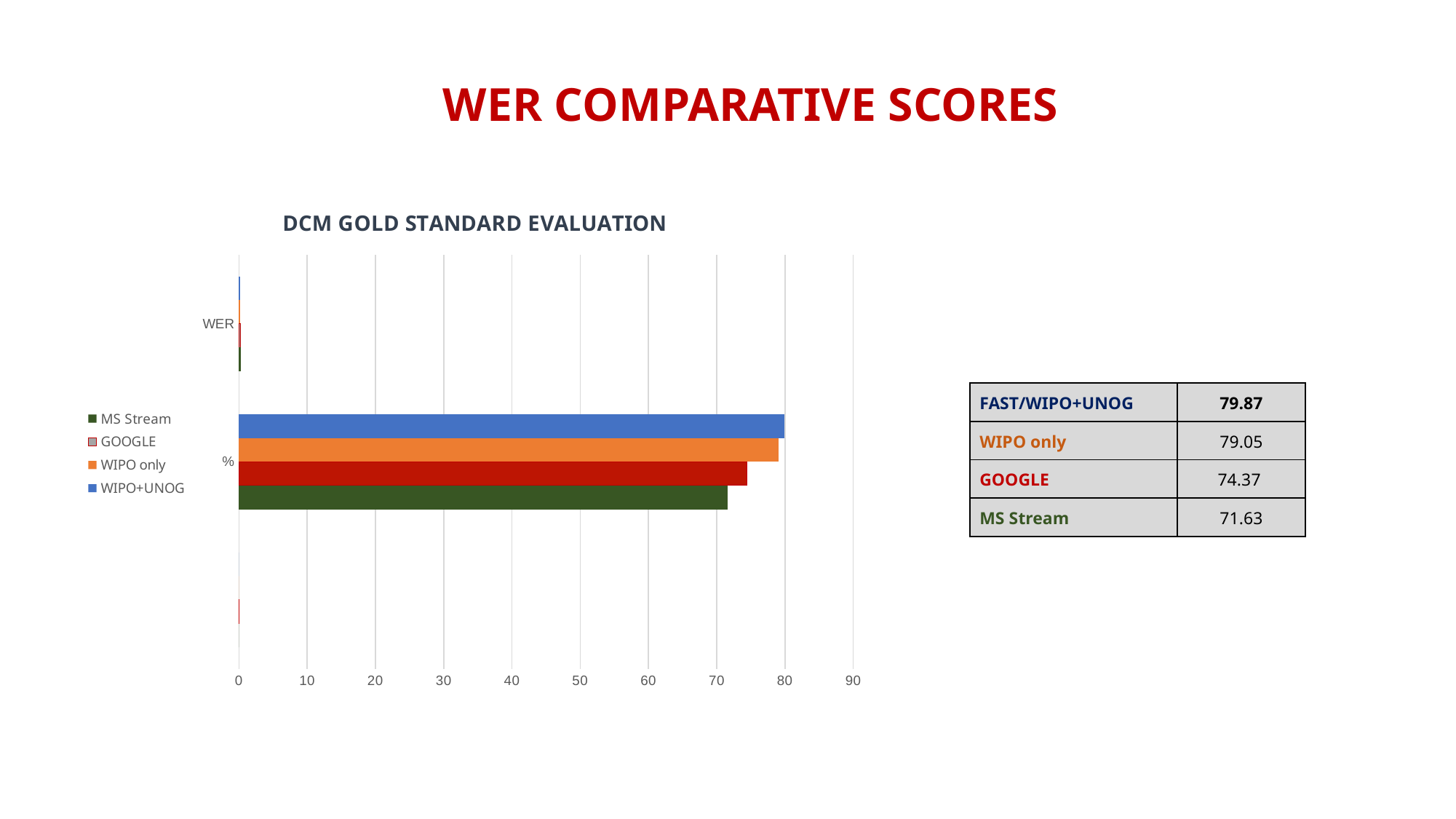
According to the table on the slide, what is the score for GOOGLE? 74.37 Using the values in the table, what is the difference between the FAST/WIPO+UNOG score and the MS Stream score? 8.24 According to the table on the slide, what is the score for MS Stream? 71.63 According to the table on the slide, what is the score for FAST/WIPO+UNOG? 79.87 In the % category of the chart, is the bar for GOOGLE longer or shorter than the bar for MS Stream? longer Which series does the legend of the chart list first? MS Stream According to the table on the slide, what is the score for WIPO only? 79.05 What kind of chart is shown under the title DCM GOLD STANDARD EVALUATION? bar chart How many series does the legend of the DCM GOLD STANDARD EVALUATION chart list? 4 What is the title of the chart on the slide? DCM GOLD STANDARD EVALUATION In the % category of the chart, is the value for GOOGLE greater or less than 70? greater In the % category of the chart, which series has the shortest bar? MS Stream